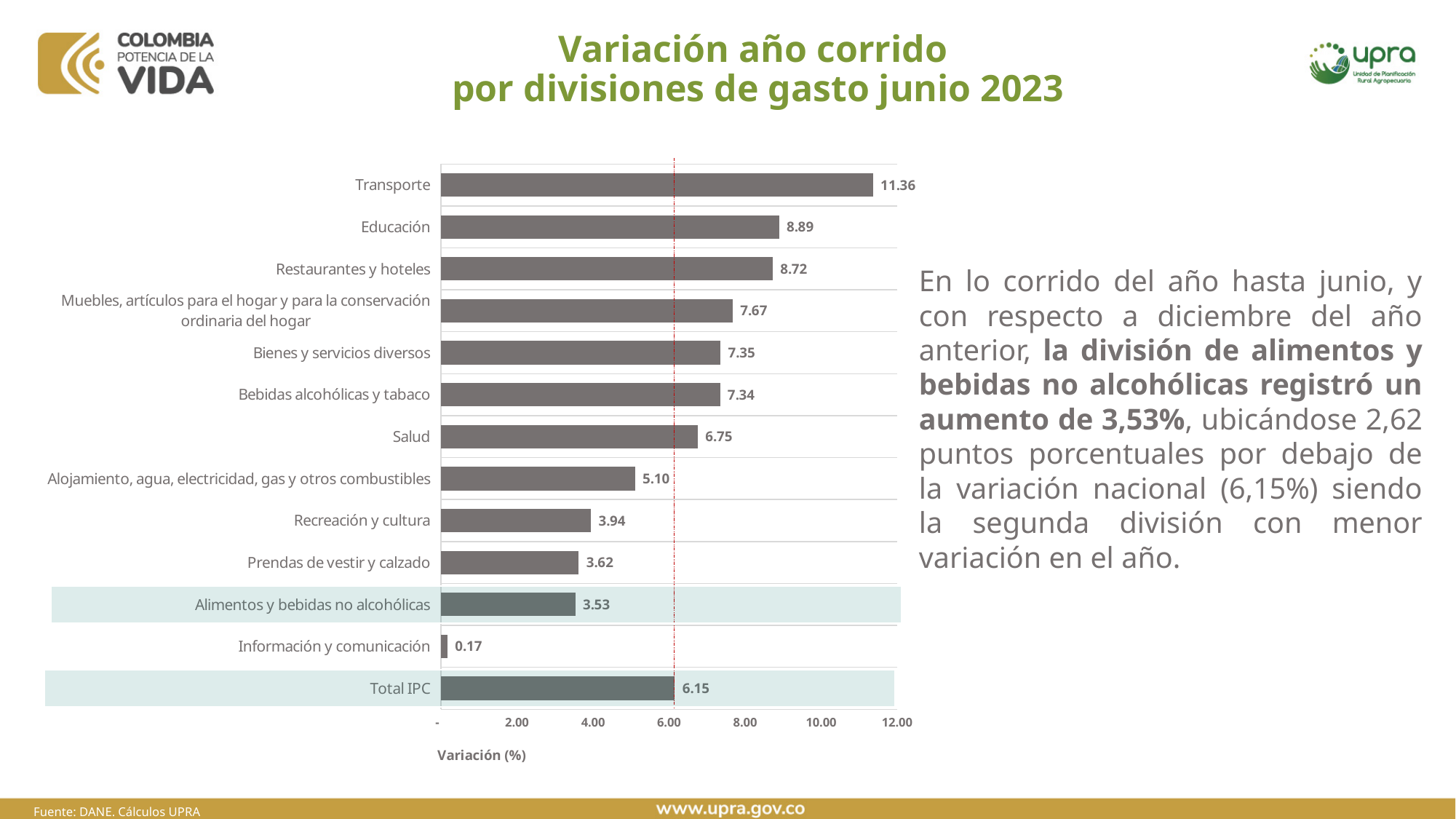
What is the value for Transporte? 11.36 Which category has the highest value? Transporte What is the label of the horizontal axis? Variación (%) What is the value for Alimentos y bebidas no alcohólicas? 3.53 How many categories are shown in the chart? 13 Which is larger, the value for Salud or the value for Alojamiento, agua, electricidad, gas y otros combustibles? Salud What is the difference between the value for Transporte and the value for Total IPC? 5.21 What is the difference between the values for Educación and Restaurantes y hoteles? 0.17 Which category has the lowest value? Información y comunicación What is the value for Total IPC? 6.15 What kind of chart is shown on the slide? Bar chart Is the value for Recreación y cultura greater or less than 4.00? less